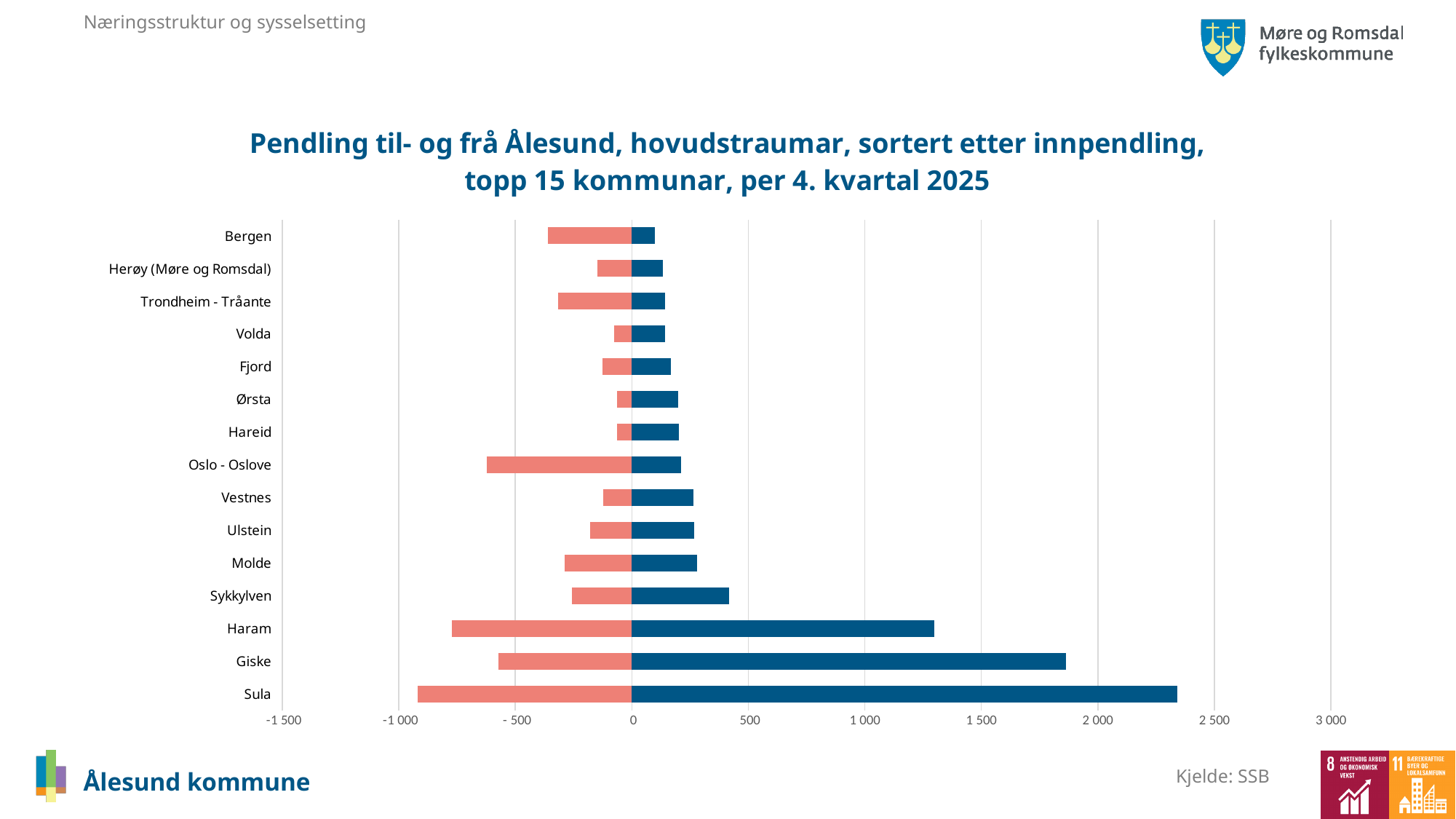
Is the value of the blue bar for Sula greater or less than 2 000? greater Which has the larger blue bar, Giske or Haram? Giske According to the chart title, which quarter and year does the data refer to? 4. kvartal 2025 Which municipality has the longest red bar (extending furthest to the left) in the chart? Sula Is the value of the red bar for Oslo - Oslove greater or less than -500? less Do the blue bars get longer or shorter moving down the chart from Bergen to Sula? longer Is the value of the blue bar for Sykkylven greater or less than 500? less Which municipality has the longest blue bar (highest innpendling) in the chart? Sula What kind of chart is shown on the slide? bar chart How many municipalities (categories) are listed on the vertical axis of the chart? 15 Which municipality has the shortest blue bar in the chart? Bergen